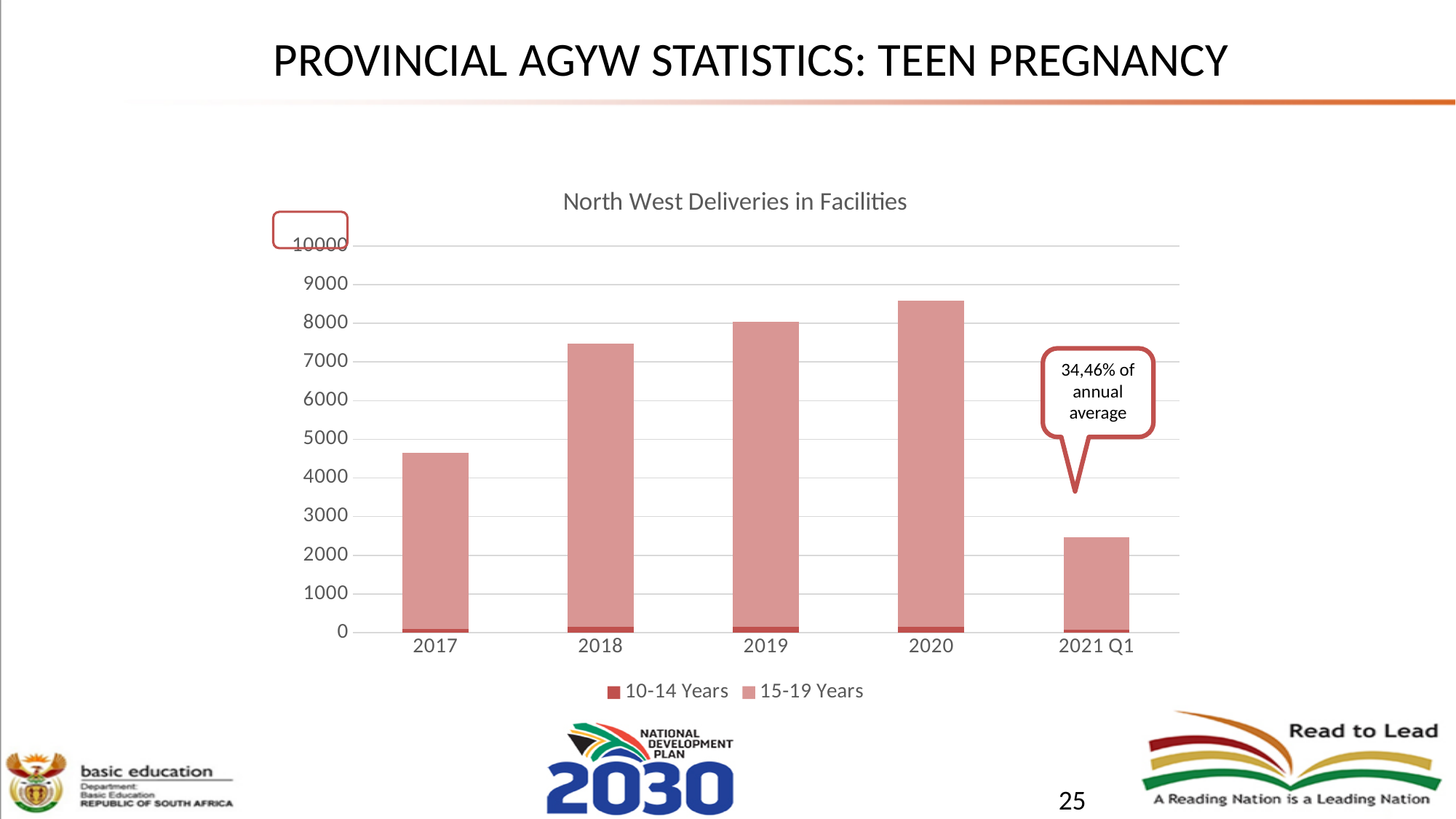
What is the title of the chart? North West Deliveries in Facilities Is the total for 2020 greater or less than 9000? less Which has a larger total, 2017 or 2018? 2018 Which category has the highest total deliveries? 2020 Do the totals rise or fall from 2017 to 2020? rise Is the total for 2021 Q1 greater or less than 3000? less Which category has the lowest total deliveries? 2021 Q1 How many series does the legend list? 2 How many categories are shown on the x axis? 5 What kind of chart is shown on the slide? bar chart Is the total for 2018 greater or less than 7000? greater